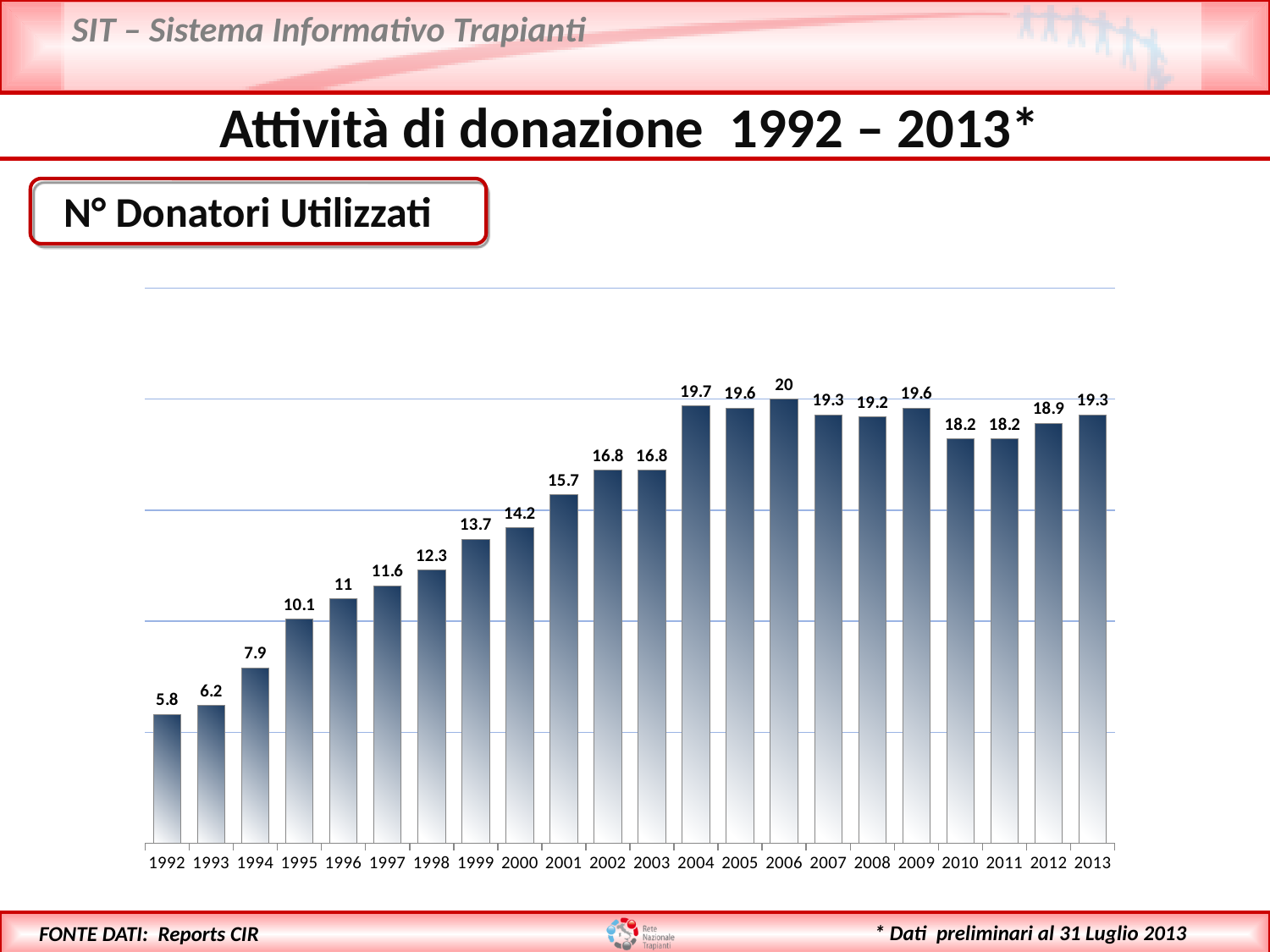
Which is larger, the value for 2004 or the value for 2010? 2004 What is the value for 1999? 13.7 Which year has the lowest value? 1992 What is the title of the chart? N° Donatori Utilizzati What is the value for 2013? 19.3 How many years are shown on the x axis? 22 Which year has the highest value? 2006 What is the value for 1992? 5.8 What is the difference between the values for 2013 and 2012? 0.4 What is the value for 2006? 20 What kind of chart is shown? bar chart What is the difference between the values for 2006 and 1992? 14.2